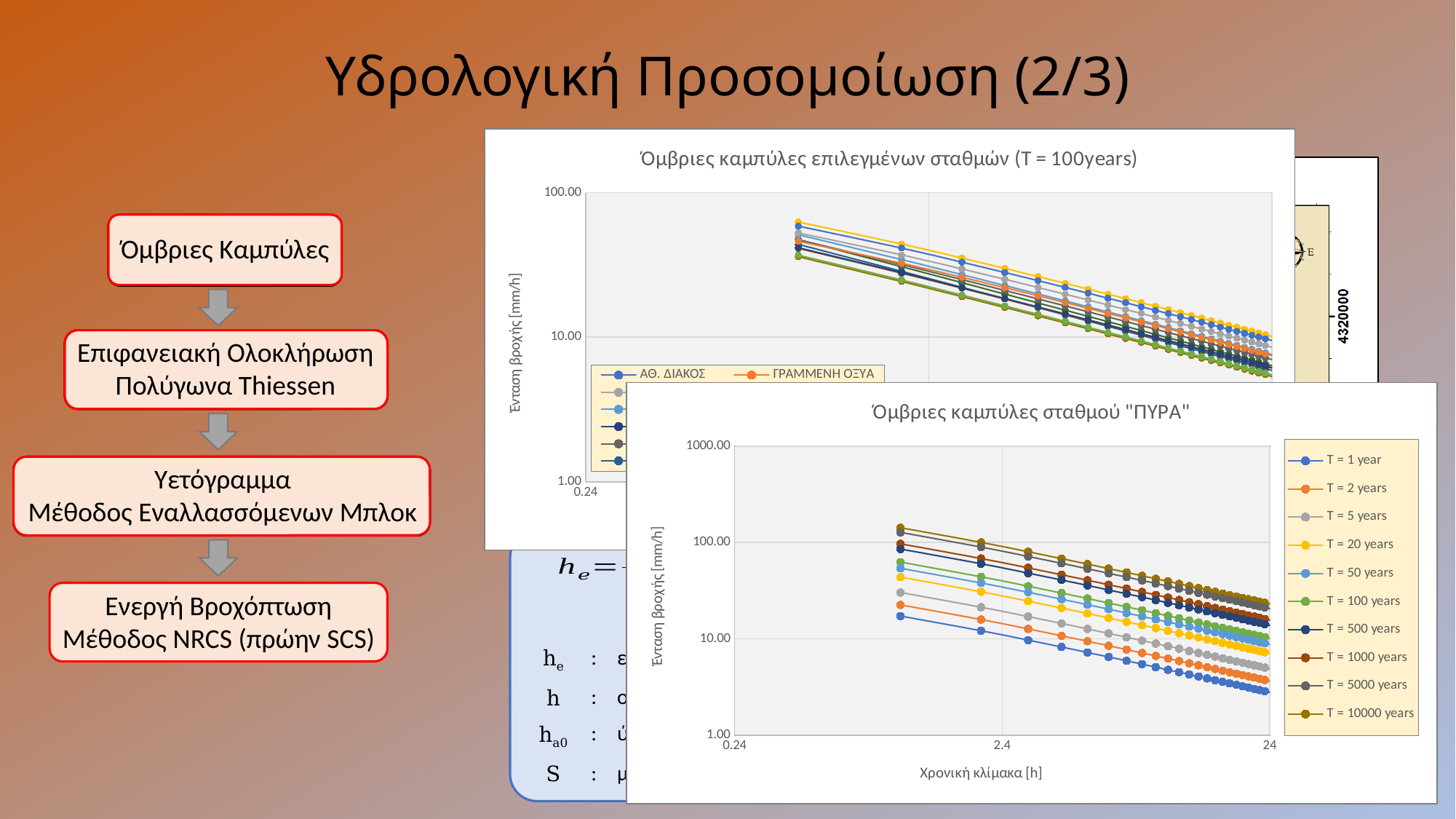
In the chart titled 'Όμβριες καμπύλες σταθμού "ΠΥΡΑ"', which series has the highest rainfall intensity values? T = 10000 years In the chart titled 'Όμβριες καμπύλες σταθμού "ΠΥΡΑ"', is the value for T = 10000 years at its leftmost point greater or less than 100.00? greater In the chart titled 'Όμβριες καμπύλες σταθμού "ΠΥΡΑ"', is the value for T = 10000 years at a time scale of 24 h greater or less than 10.00? greater In the chart titled 'Όμβριες καμπύλες σταθμού "ΠΥΡΑ"', is the value for T = 1 year at a time scale of 24 h greater or less than 10.00? less What is the title of the chart in the background, behind the 'ΠΥΡΑ' chart? Όμβριες καμπύλες επιλεγμένων σταθμών (T = 100years) In the chart titled 'Όμβριες καμπύλες σταθμού "ΠΥΡΑ"', do the values rise or fall as the time scale increases along the x axis? Fall In the background chart titled 'Όμβριες καμπύλες επιλεγμένων σταθμών (T = 100years)', do the curves rise or fall along the x axis? Fall In the chart titled 'Όμβριες καμπύλες σταθμού "ΠΥΡΑ"', which series has the lowest rainfall intensity values? T = 1 year What is the x-axis label of the chart titled 'Όμβριες καμπύλες σταθμού "ΠΥΡΑ"'? Χρονική κλίμακα [h] In the chart titled 'Όμβριες καμπύλες σταθμού "ΠΥΡΑ"', which series has larger values at a time scale of 24 h: T = 1000 years or T = 2 years? T = 1000 years In the chart titled 'Όμβριες καμπύλες σταθμού "ΠΥΡΑ"', how many series does the legend list? 10 What kind of chart is the chart titled 'Όμβριες καμπύλες σταθμού "ΠΥΡΑ"'? Line chart